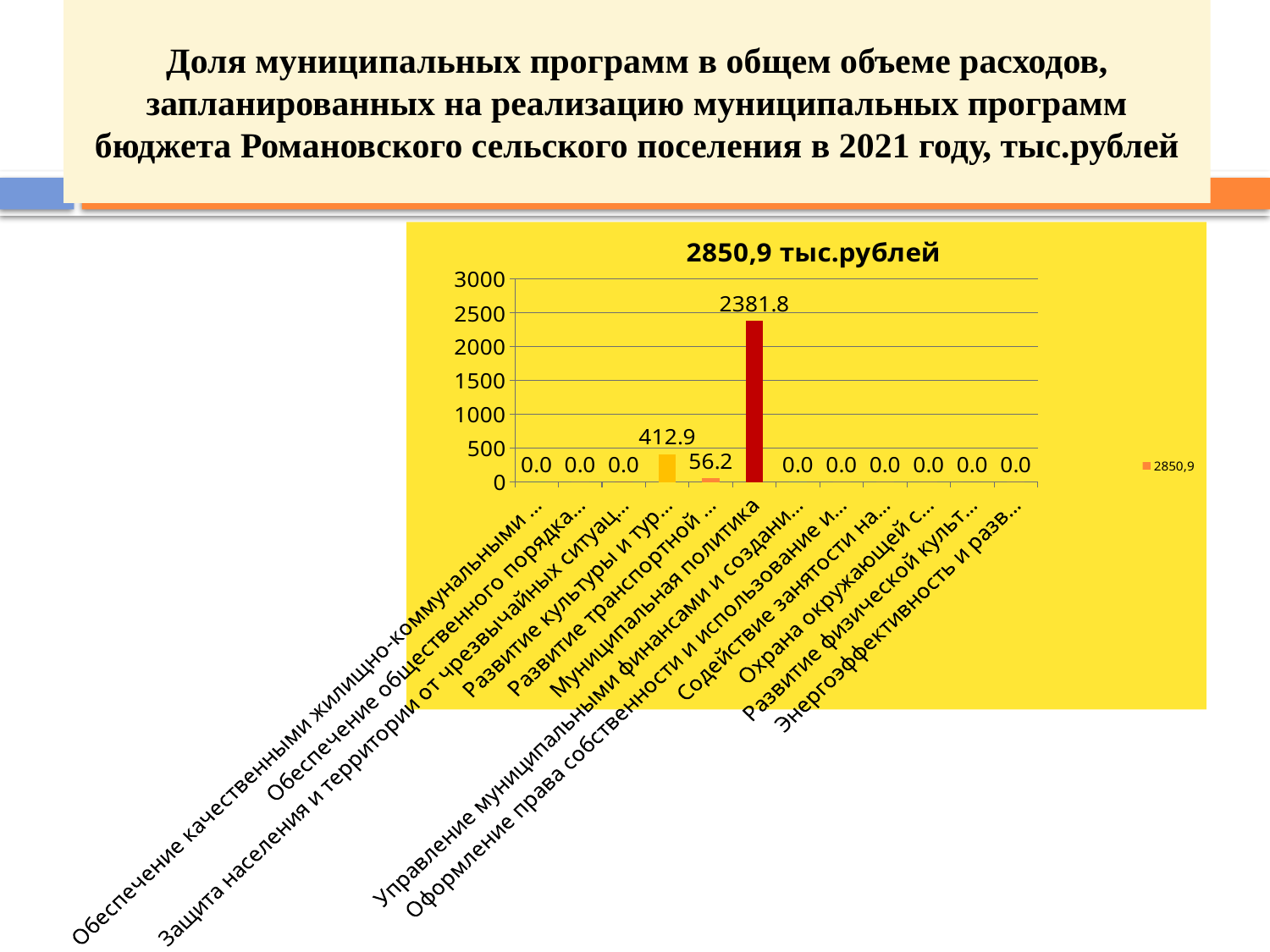
How many categories are shown on the x axis? 12 What is the difference between the values for Развитие культуры и тур... and Развитие транспортной ...? 356.7 Is the value for Муниципальная политика greater or less than 2000? greater Which category has the highest value? Муниципальная политика How many categories have a value of 0.0? 9 What is the value for Развитие транспортной ...? 56.2 What is the difference between the values for Муниципальная политика and Развитие культуры и тур...? 1968.9 What is the value for Развитие культуры и тур...? 412.9 What is the value for Муниципальная политика? 2381.8 What kind of chart is shown? bar chart What is the title of the chart? 2850,9 тыс.рублей Which is larger, the value for Развитие культуры и тур... or the value for Развитие транспортной ...? Развитие культуры и тур...